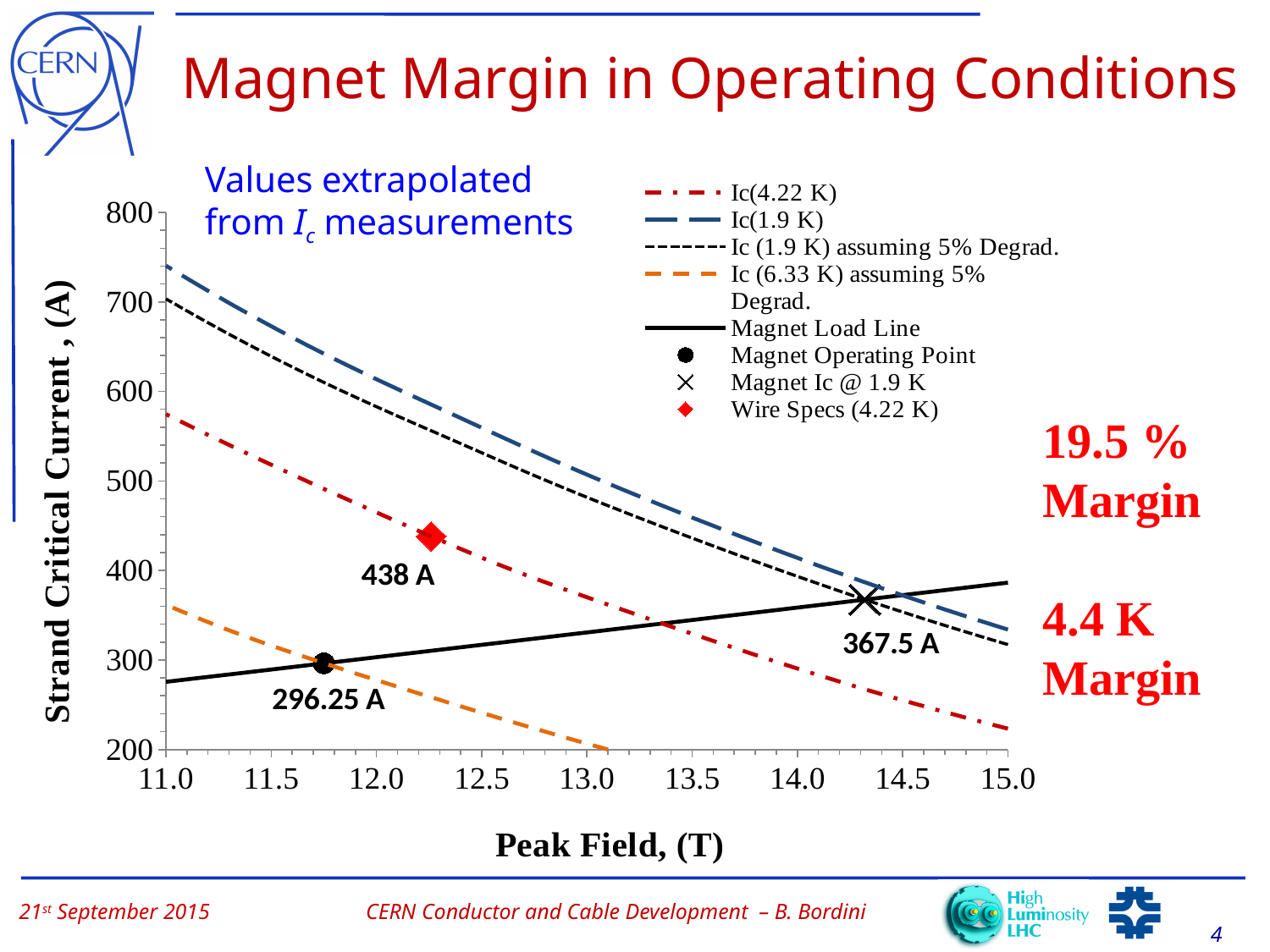
How many entries does the legend list? 8 What is the labelled current value at the Magnet Ic @ 1.9 K point? 367.5 A Which is larger, the Wire Specs (4.22 K) value or the Magnet Ic @ 1.9 K value? Wire Specs (4.22 K) Is the Ic(1.9 K) value at 11.0 T greater or less than 700? greater Of the three labelled points, which has the highest current value? Wire Specs (4.22 K) What is the labelled current value at the Wire Specs (4.22 K) point? 438 A What is the title of the y axis? Strand Critical Current , (A) Does the Ic(1.9 K) curve rise or fall as the peak field increases? Fall What is the labelled current value at the Magnet Operating Point? 296.25 A What is the difference between the Wire Specs (4.22 K) value and the Magnet Ic @ 1.9 K value? 70.5 A What kind of chart is shown on the slide? Line chart What is the difference between the Magnet Ic @ 1.9 K value and the Magnet Operating Point value? 71.25 A